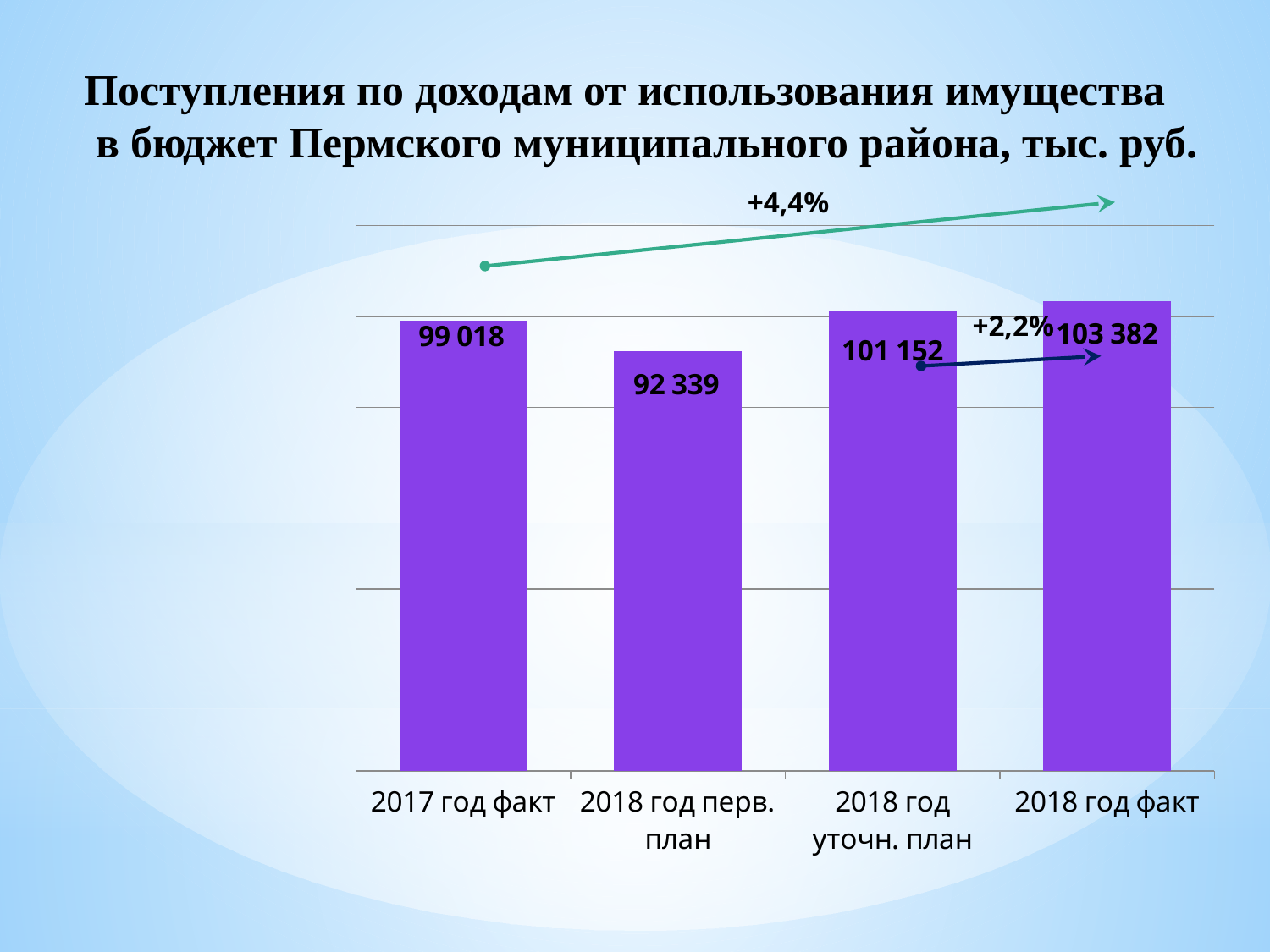
What is the difference between the values for 2018 год уточн. план and 2018 год перв. план? 8 813 What is the difference between the values for 2018 год факт and 2017 год факт? 4 364 Which category has the lowest value? 2018 год перв. план What is the value for 2018 год уточн. план? 101 152 What percentage change is shown by the arrow from 2017 год факт to 2018 год факт? +4,4% What is the value for 2017 год факт? 99 018 What kind of chart is shown on the slide? bar chart What is the value for 2018 год факт? 103 382 Which category has the highest value? 2018 год факт How many categories are shown on the x axis? 4 What is the value for 2018 год перв. план? 92 339 Which is larger, the value for 2017 год факт or the value for 2018 год перв. план? 2017 год факт